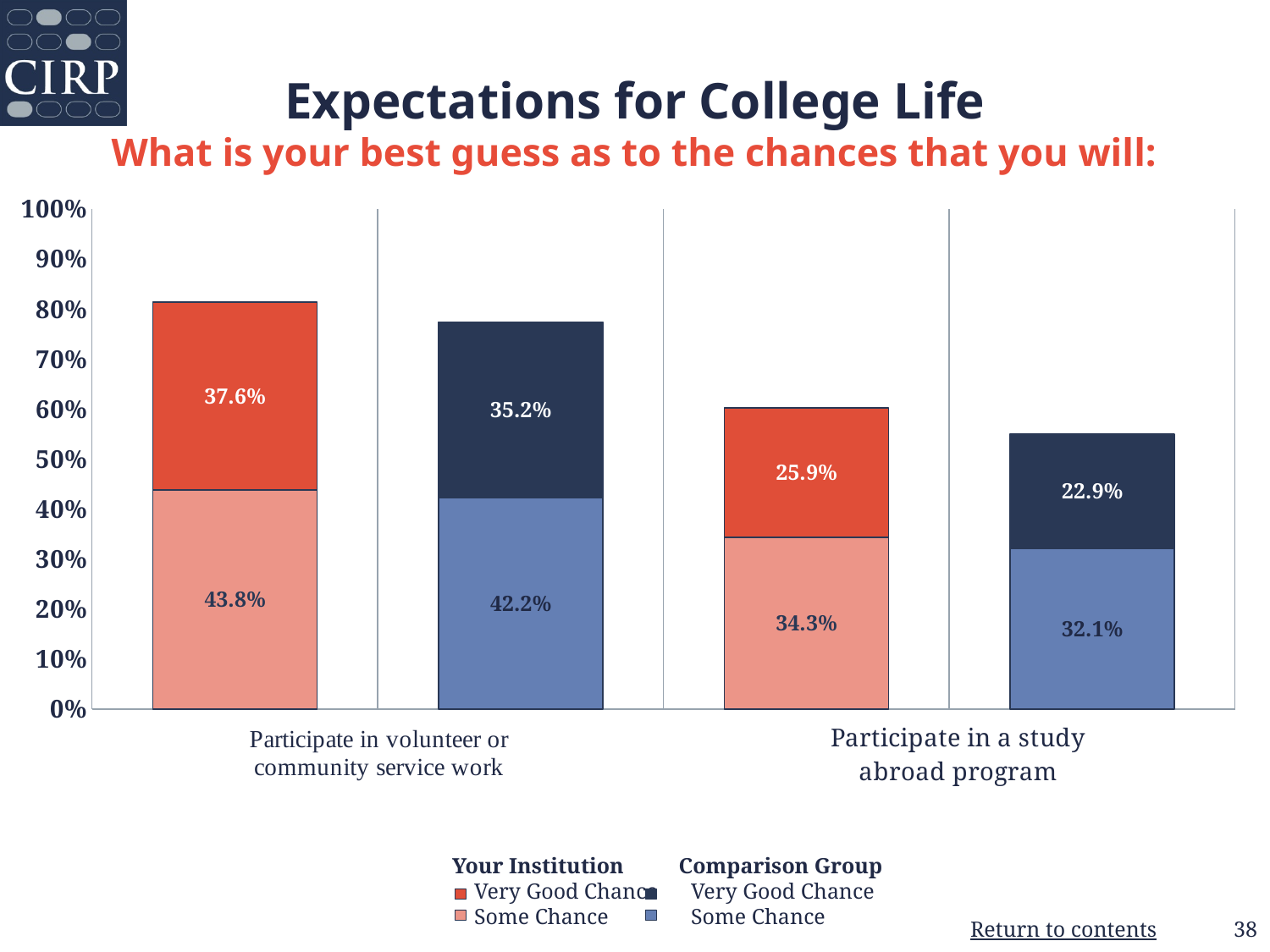
Which 'Very Good Chance' segment is the lowest on the chart? Comparison Group, participate in a study abroad program Which is larger for participating in volunteer or community service work: the 'Some Chance' value for Your Institution or for the Comparison Group? Your Institution What is the total height of the Your Institution stacked bar for participating in volunteer or community service work? 81.4% What is the difference between the Your Institution and Comparison Group 'Very Good Chance' values for participating in a study abroad program? 3.0% What is the 'Very Good Chance' value for Your Institution for participating in volunteer or community service work? 37.6% What kind of chart is shown on the slide? Stacked bar chart What is the 'Some Chance' value for Your Institution for participating in volunteer or community service work? 43.8% Is the total of the Your Institution stacked bar for participating in a study abroad program greater or less than 50%? greater What is the total height of the Comparison Group stacked bar for participating in a study abroad program? 55.0% How many entries does the legend list? 4 What is the 'Some Chance' value for the Comparison Group for participating in a study abroad program? 32.1% What is the 'Very Good Chance' value for the Comparison Group for participating in a study abroad program? 22.9%